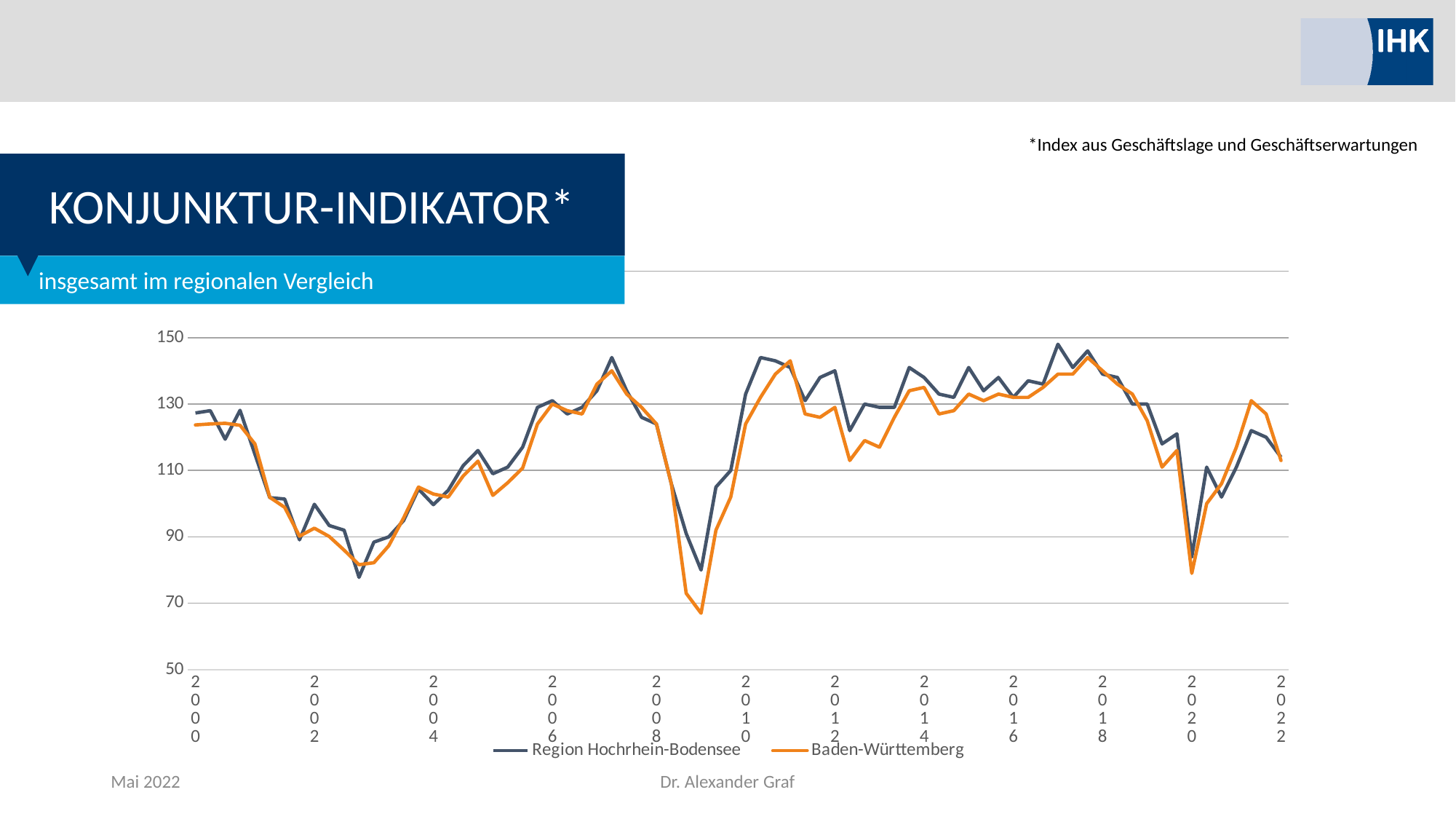
What kind of chart is shown on the slide? line chart Around 2009, which series drops to the lower value, Region Hochrhein-Bodensee or Baden-Württemberg? Baden-Württemberg How many series does the legend list? 2 Is the value for Region Hochrhein-Bodensee at its 2009 low greater or less than 90? less What is the title of the chart on the slide? KONJUNKTUR-INDIKATOR Is the lowest value of the Baden-Württemberg series (around 2009) greater or less than 70? less Is the highest value of the Region Hochrhein-Bodensee series (around 2018) greater or less than 130? greater Around 2020, which series drops to the lower value, Region Hochrhein-Bodensee or Baden-Württemberg? Baden-Württemberg Does the Baden-Württemberg series rise or fall between 2000 and 2003? fall How many year labels are shown on the x axis? 12 Which two series are listed in the chart legend? Region Hochrhein-Bodensee and Baden-Württemberg Do the values of both series rise or fall between 2018 and 2020? fall